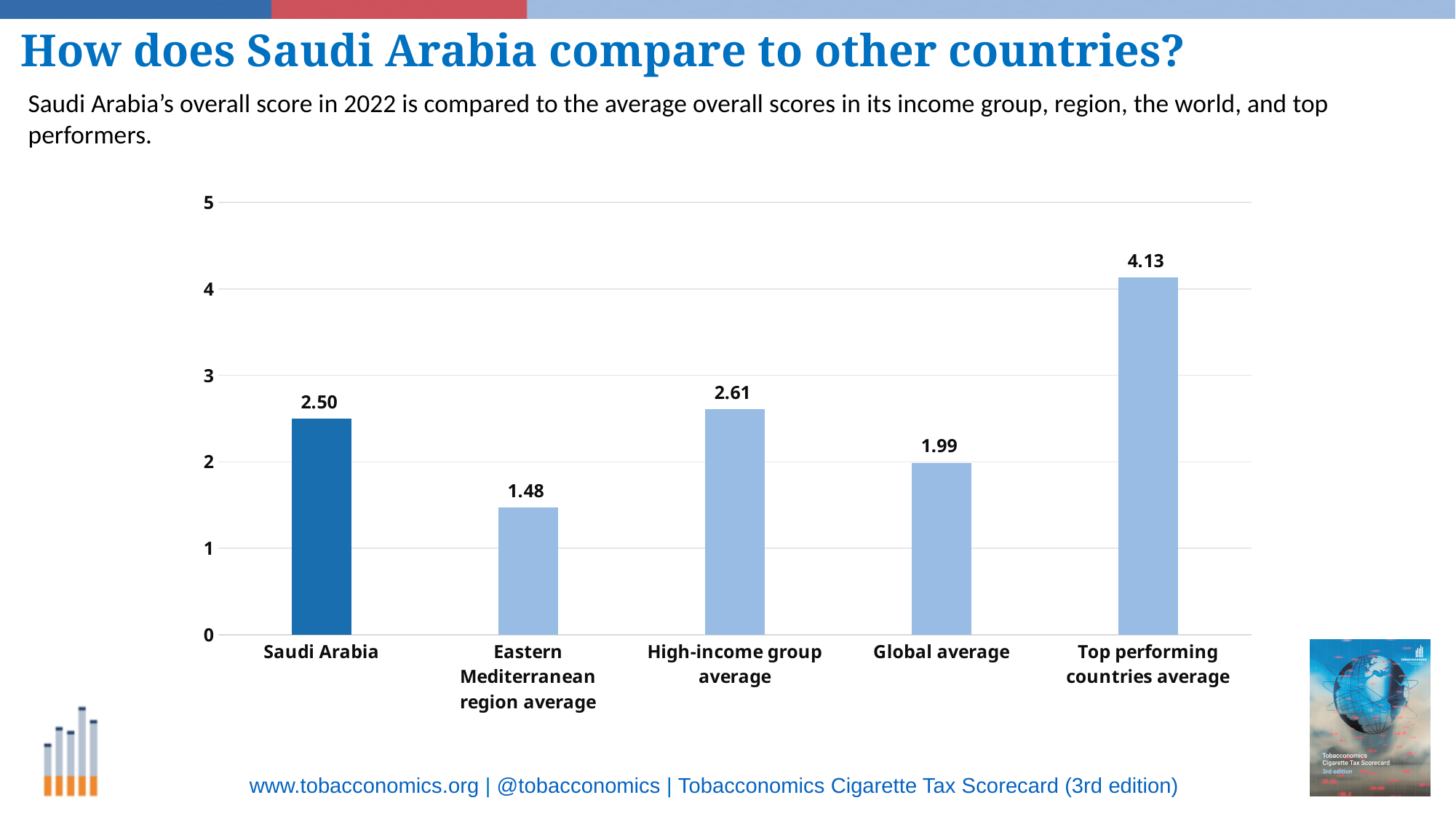
Is the value for the High-income group average greater or less than 3? less What is the difference between the Top performing countries average and Saudi Arabia's score? 1.63 What is the value shown for the High-income group average? 2.61 What is the value shown for the Eastern Mediterranean region average? 1.48 Which category has the lowest value? Eastern Mediterranean region average What is the value shown for the Top performing countries average? 4.13 How many categories are shown on the chart? 5 Which category has the highest value? Top performing countries average What is the overall score shown for Saudi Arabia? 2.50 What kind of chart is shown on the slide? bar chart What is the value shown for the Global average? 1.99 Which is larger, the value for Saudi Arabia or the Global average? Saudi Arabia